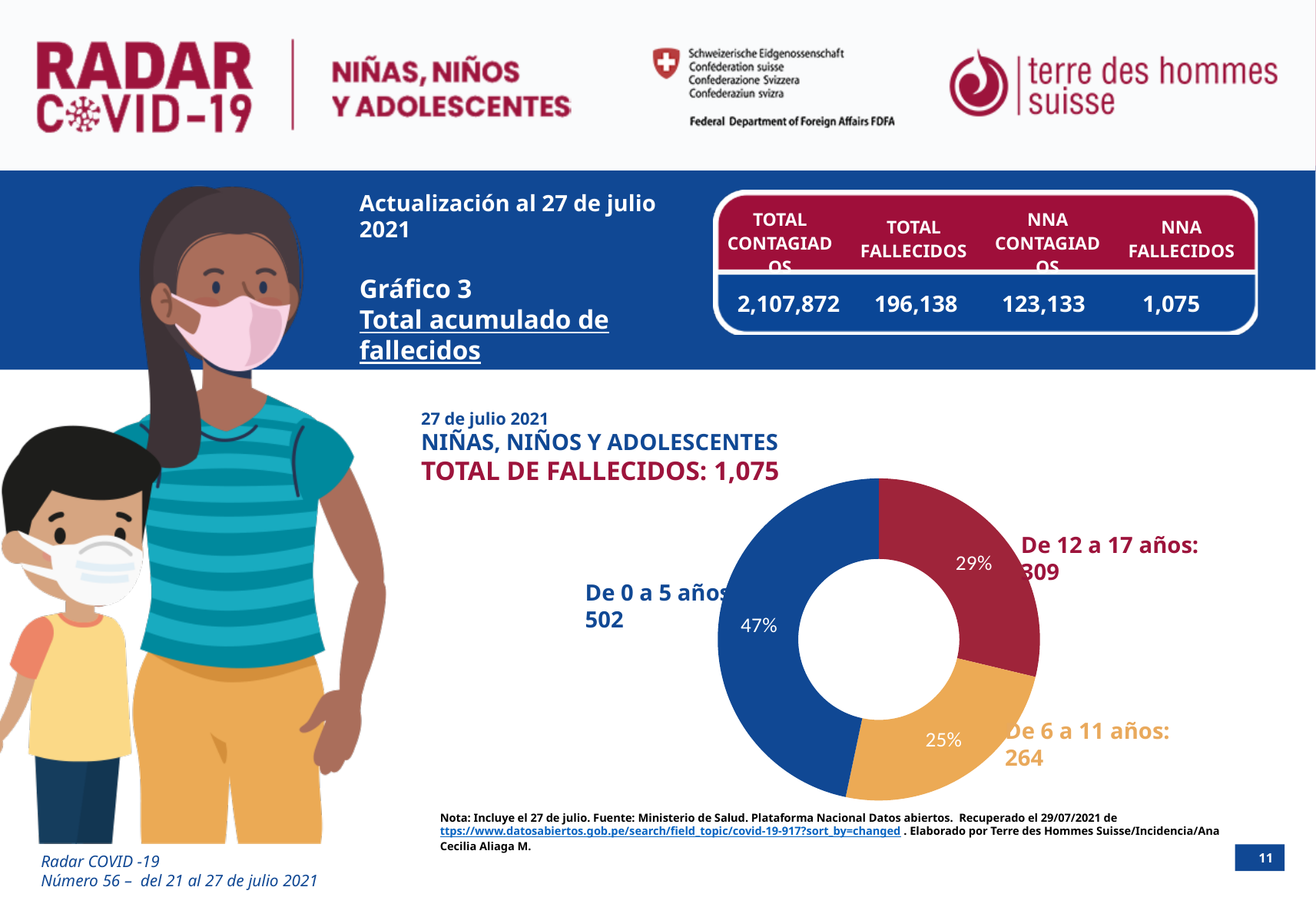
What total number of deaths is stated in the chart's title? 1,075 What is the number of deaths shown for the 'De 12 a 17 años' group? 309 Which age group has the largest share of the donut chart? De 0 a 5 años What is the difference in deaths between the 'De 0 a 5 años' group and the 'De 12 a 17 años' group? 193 How many age-group categories does the donut chart show? 3 What percentage of the donut chart does the 'De 0 a 5 años' group represent? 47% What is the number of deaths shown for the 'De 0 a 5 años' group? 502 What is the number of deaths shown for the 'De 6 a 11 años' group? 264 Which group has more deaths, 'De 12 a 17 años' or 'De 6 a 11 años'? De 12 a 17 años Which age group has the smallest share of the donut chart? De 6 a 11 años What kind of chart is shown on the slide? Donut (pie) chart What percentage of the donut chart does the 'De 6 a 11 años' group represent? 25%